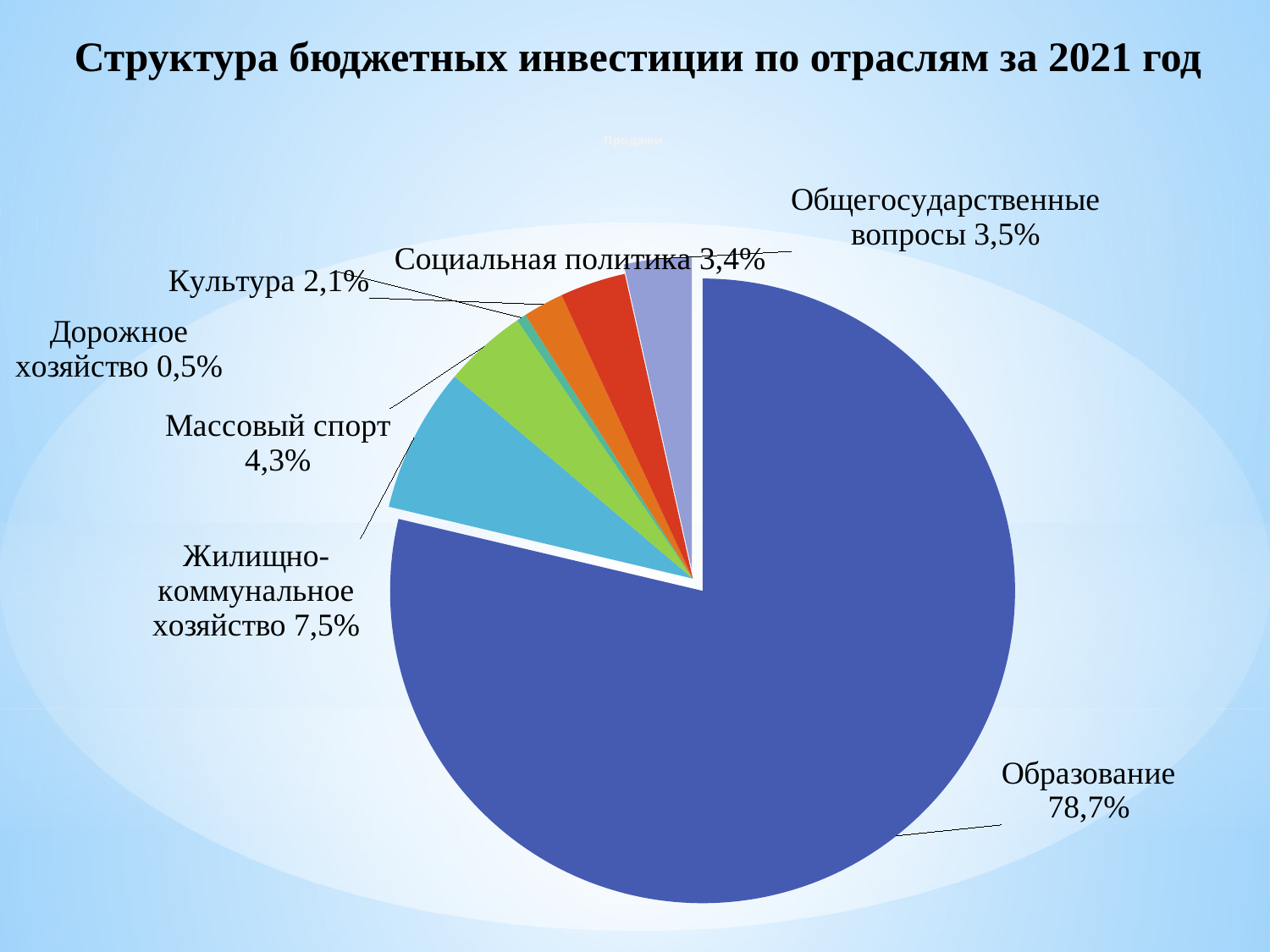
What is the difference between the shares of Образование and Жилищно-коммунальное хозяйство? 71,2% What percentage is shown for Массовый спорт? 4,3% What kind of chart is shown on the slide? pie chart What is the value for Дорожное хозяйство? 0,5% What share of budget investments went to Образование? 78,7% Which sector has the largest share of the pie? Образование Which is larger, the share for Жилищно-коммунальное хозяйство or the share for Массовый спорт? Жилищно-коммунальное хозяйство Which sector has the smallest share of the pie? Дорожное хозяйство What is the value shown for Жилищно-коммунальное хозяйство? 7,5% What share is labelled for Социальная политика? 3,4% How many slices does the pie chart have? 7 What is the title of the slide? Структура бюджетных инвестиции по отраслям за 2021 год